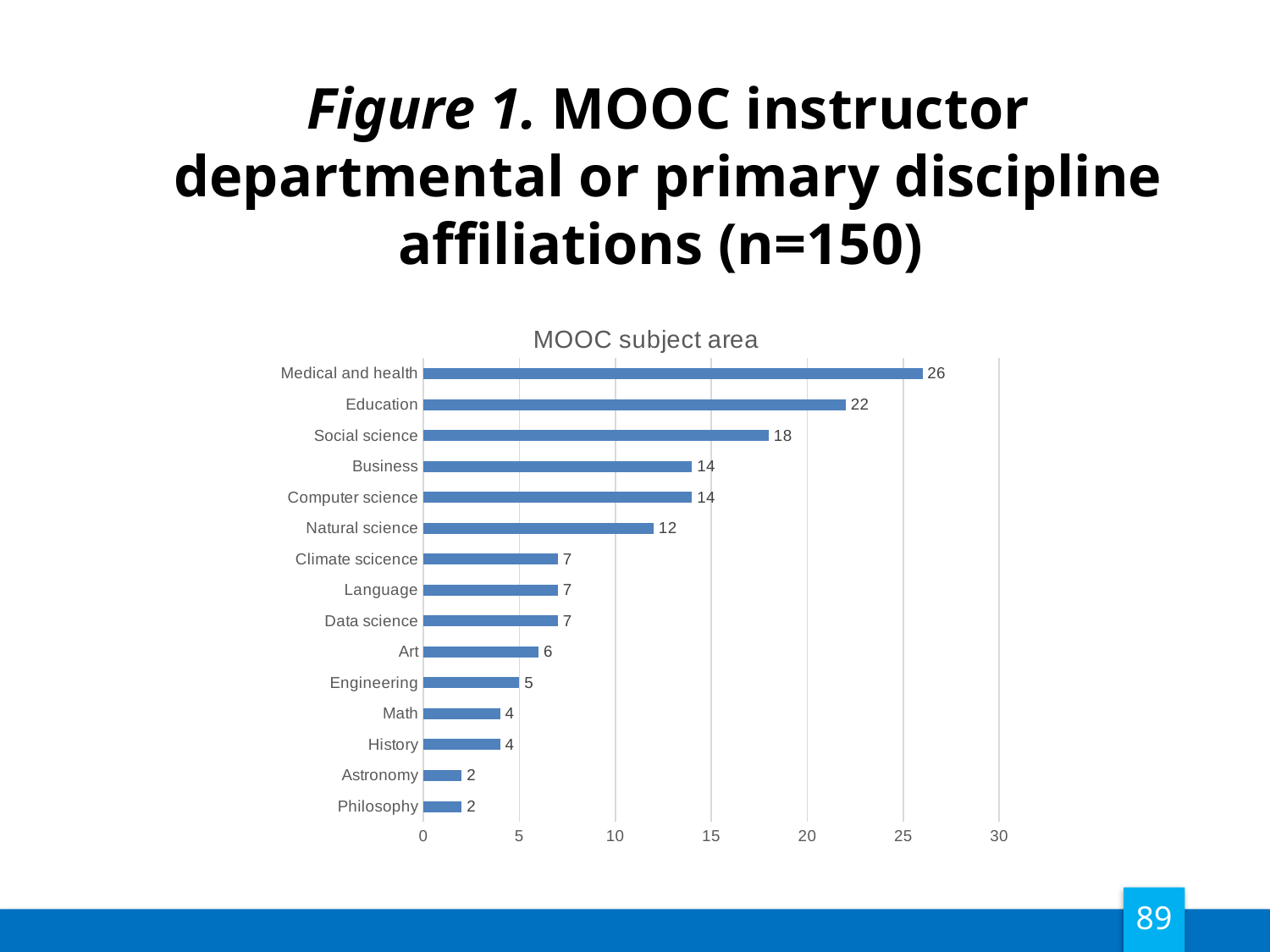
What is the difference between the values for Medical and health and Philosophy? 24 What kind of chart is shown on the slide? Bar chart What is the value for Social science? 18 What is the value for Medical and health? 26 Is the value for Education greater or less than 20? greater What is the value for Engineering? 5 How many categories are shown in the chart? 15 What is the value for Natural science? 12 What is the title of the chart? MOOC subject area Which category has the highest value? Medical and health What is the difference between the values for Education and Business? 8 Which is larger, the value for Art or the value for Engineering? Art